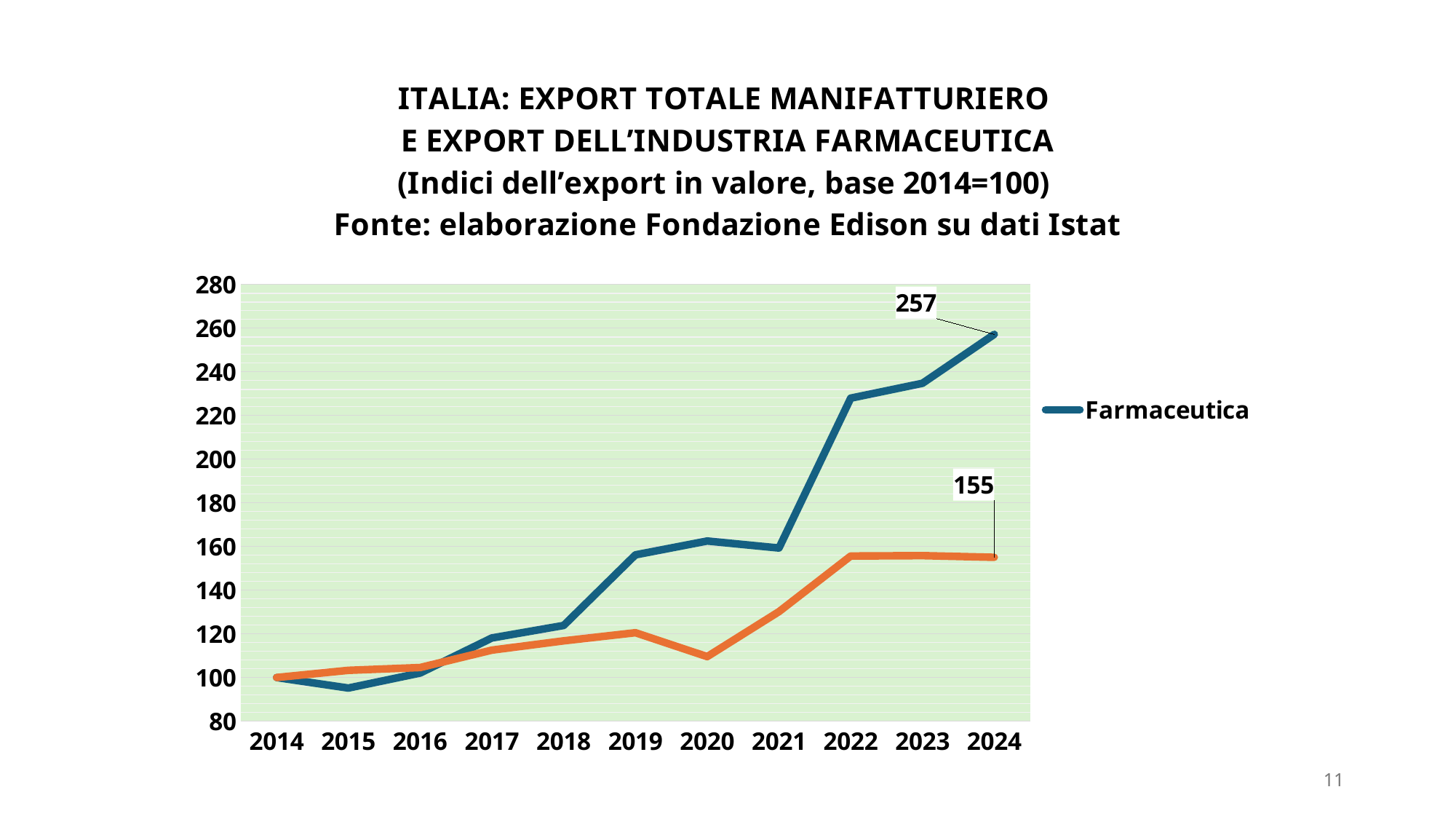
How many years are shown on the x axis? 11 Is the value of the orange line in 2020 greater or less than 120? less What kind of chart is shown on the slide? line chart In which year does the Farmaceutica series reach its lowest value? 2015 In which year does the Farmaceutica series reach its highest value? 2024 How many series does the legend list? 1 In 2024, which is larger: the Farmaceutica series or the orange line? Farmaceutica What is the difference between the Farmaceutica value and the orange line value in 2024? 102 Is the Farmaceutica value for 2022 greater or less than 200? greater What is the value of the orange line in 2024? 155 What is the value of the Farmaceutica series in 2024? 257 Does the Farmaceutica series rise or fall overall from 2014 to 2024? rise